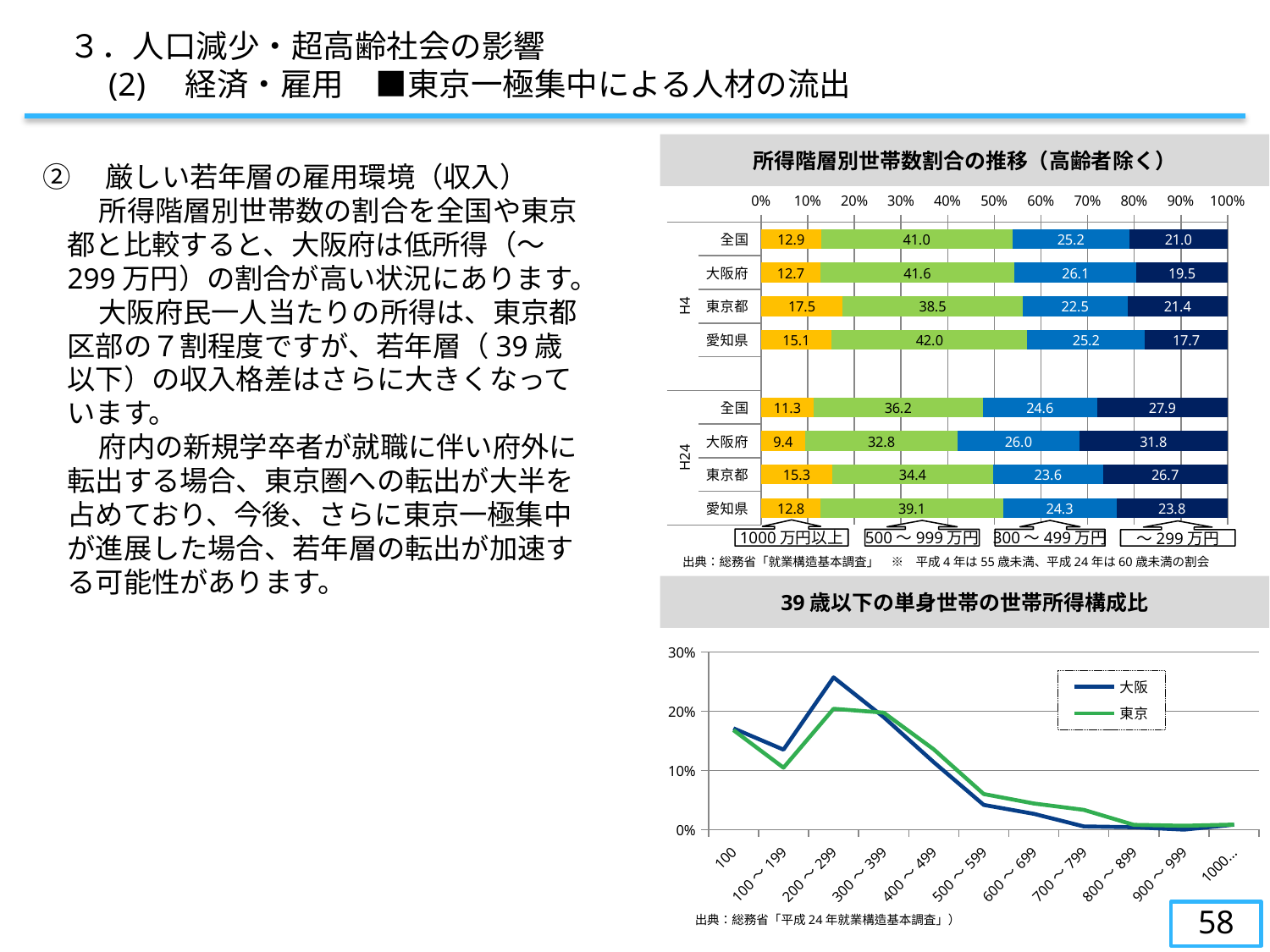
What kind of chart is the chart titled 39歳以下の単身世帯の世帯所得構成比? line chart In the chart titled 所得階層別世帯数割合の推移（高齢者除く）, is the 500～999万円 value for 全国 in H4 larger or smaller than that for 東京都 in H4? larger In the chart titled 39歳以下の単身世帯の世帯所得構成比, which series has the higher value at 200～299, 大阪 or 東京? 大阪 In the chart titled 39歳以下の単身世帯の世帯所得構成比, is the value for 大阪 at 200～299 greater or less than 20%? greater In the chart titled 39歳以下の単身世帯の世帯所得構成比, how many series does the legend list? 2 In the chart titled 所得階層別世帯数割合の推移（高齢者除く）, what is the value of the 1000万円以上 segment for 東京都 in H4? 17.5 In the chart titled 所得階層別世帯数割合の推移（高齢者除く）, how many series does the legend list? 4 In the chart titled 所得階層別世帯数割合の推移（高齢者除く）, what is the value of the ～299万円 segment for 大阪府 in H24? 31.8 In the chart titled 所得階層別世帯数割合の推移（高齢者除く）, what is the value of the 500～999万円 segment for 愛知県 in H24? 39.1 In the chart titled 所得階層別世帯数割合の推移（高齢者除く）, which region in H24 has the lowest 1000万円以上 value? 大阪府 In the chart titled 所得階層別世帯数割合の推移（高齢者除く）, what is the difference between the ～299万円 values for 大阪府 in H24 and in H4? 12.3 In the chart titled 所得階層別世帯数割合の推移（高齢者除く）, which region in H24 has the highest ～299万円 value? 大阪府